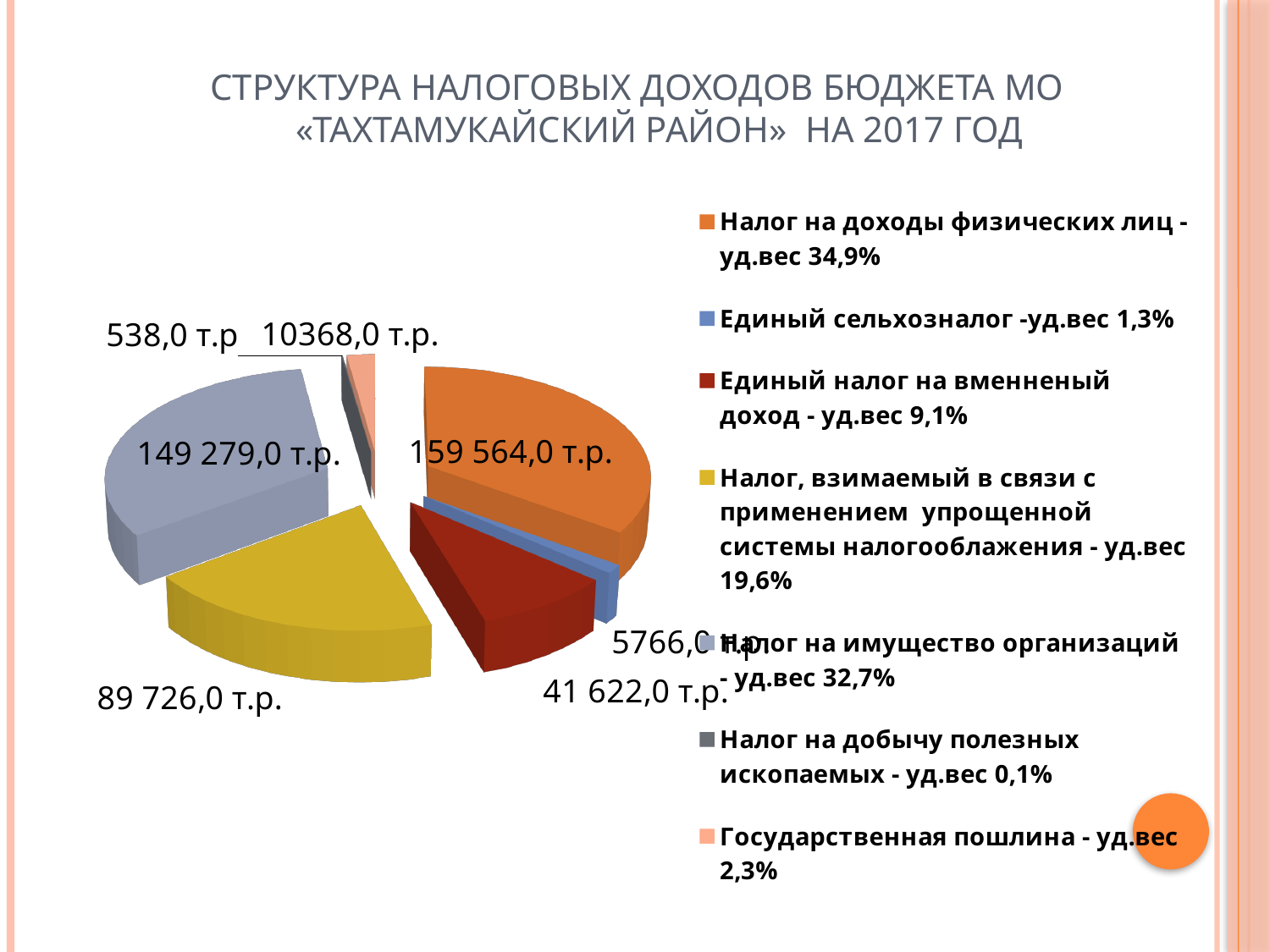
What is the value shown for Государственная пошлина? 10368,0 т.р. Which category has the smallest slice of the pie? Налог на добычу полезных ископаемых What is the value shown for Налог, взимаемый в связи с применением упрощенной системы налогооблажения? 89 726,0 т.р. What is the difference between the values for Налог на доходы физических лиц and Налог на имущество организаций? 10 285,0 т.р. What share of the pie does Налог на имущество организаций represent, according to the legend? 32,7% What kind of chart is shown on the slide? Pie chart Which category has the largest slice of the pie? Налог на доходы физических лиц How many slices (categories) does the pie chart have? 7 What is the value shown for Налог на доходы физических лиц? 159 564,0 т.р. What is the value shown for Единый налог на вменненый доход? 41 622,0 т.р. What is the value shown for Налог на имущество организаций? 149 279,0 т.р. Which is larger: the value for Налог, взимаемый в связи с применением упрощенной системы налогооблажения or the value for Единый налог на вменненый доход? Налог, взимаемый в связи с применением упрощенной системы налогооблажения